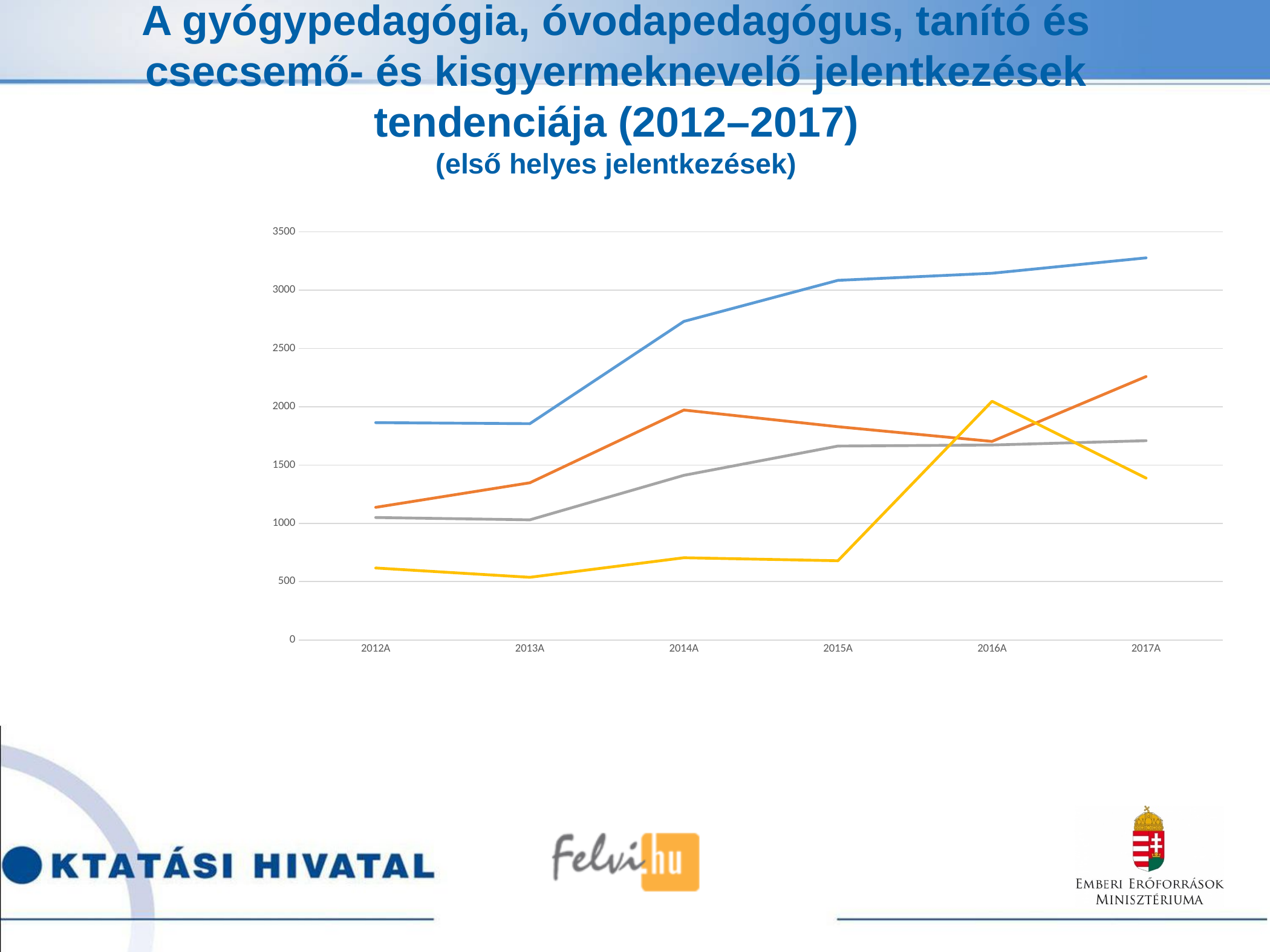
At 2016A, which is larger: the yellow line or the orange line? the yellow line At 2017A, which is larger: the orange line or the grey line? the orange line How many years are shown on the x axis of the chart? 6 Is the value of the blue line at 2017A greater or less than 3000? greater Is the value of the grey line at 2012A greater or less than 1500? less Which line has the highest value at 2017A? the blue line Does the blue line rise or fall from 2012A to 2017A? rise Is the value of the yellow line at 2013A greater or less than 1000? less How many lines are plotted on the chart? 4 What kind of chart is shown on the slide? line chart Which line has the lowest value at 2012A? the yellow line